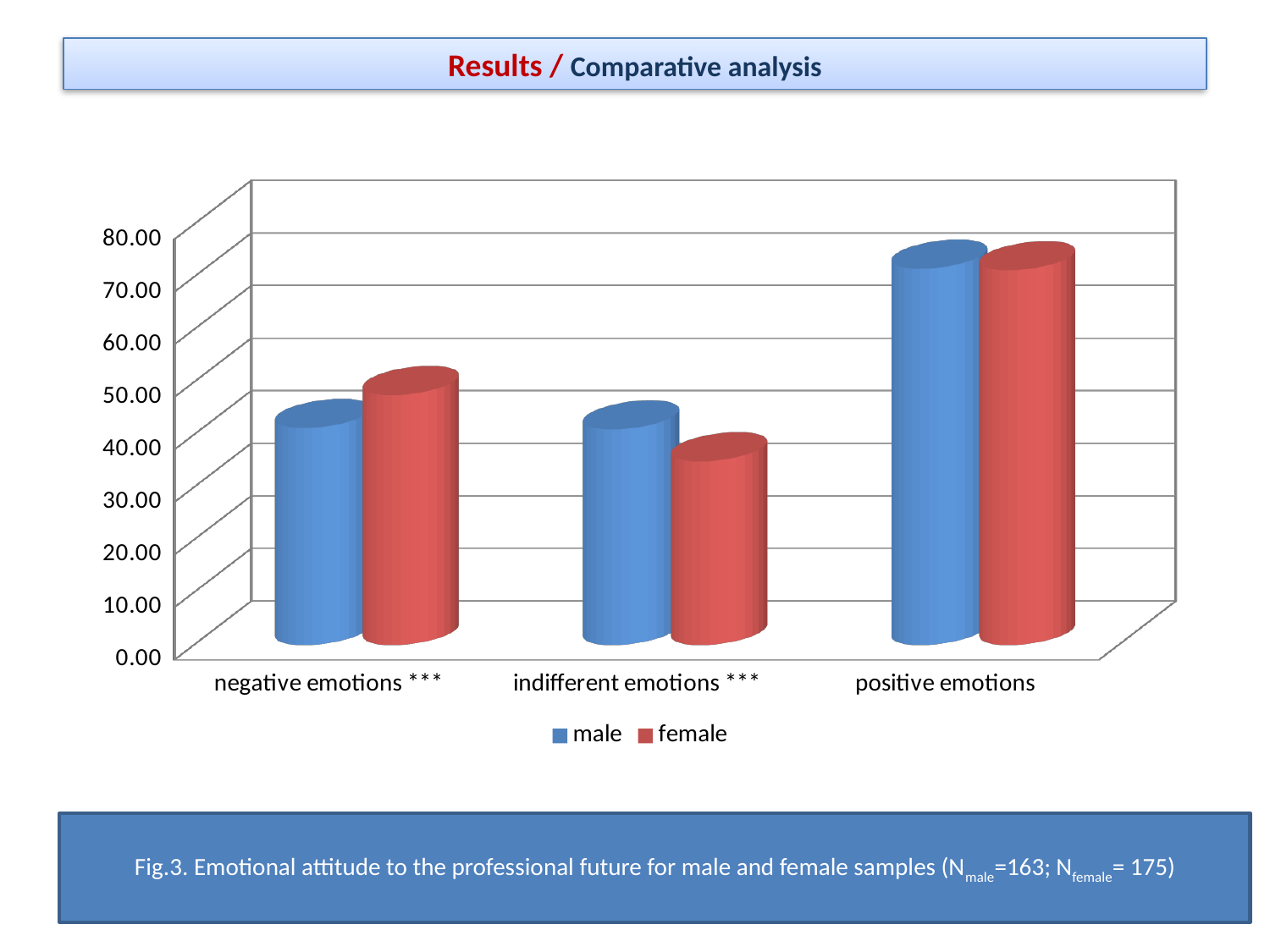
What kind of chart is shown on the slide? bar chart Is the male value for positive emotions greater or less than 60? greater Which category has the lowest value for the female series? indifferent emotions *** Is the female value for negative emotions greater or less than 40? greater Is the male value for indifferent emotions greater or less than 50? less For indifferent emotions, which series has the larger value, male or female? male Which category has the highest value for the female series? positive emotions What are the two series named in the chart's legend? male and female Which category has the highest value for the male series? positive emotions For negative emotions, which series has the larger value, male or female? female How many series does the chart's legend list? 2 How many emotion categories are shown on the x axis of the chart? 3